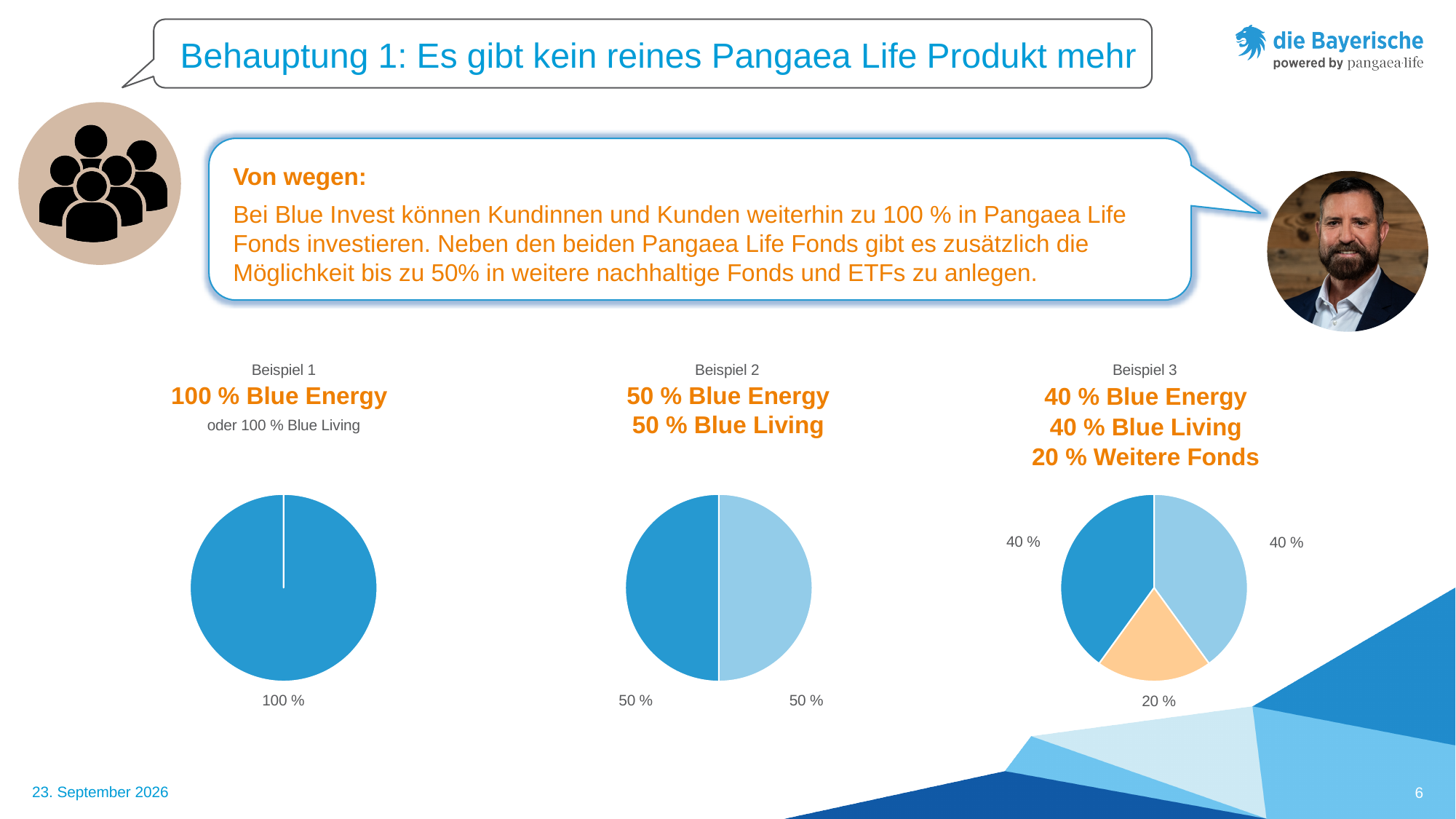
How many slices does the Beispiel 2 pie chart have? 2 In the Beispiel 3 pie chart, is the Blue Energy slice larger or smaller than the Weitere Fonds slice? larger In the Beispiel 2 pie chart, what share does Blue Energy have? 50 % In the Beispiel 3 pie chart, what is the difference between the Blue Living share and the Weitere Fonds share? 20 % In the Beispiel 3 pie chart, what share does Weitere Fonds have? 20 % How many slices does the Beispiel 3 pie chart have? 3 What kind of chart is used in Beispiel 1? pie chart How many pie charts are shown on the slide? 3 In the Beispiel 1 pie chart, what value is shown on the data label? 100 % In the Beispiel 3 pie chart, what share does Blue Energy have? 40 % In the Beispiel 3 pie chart, which category has the smallest slice? Weitere Fonds